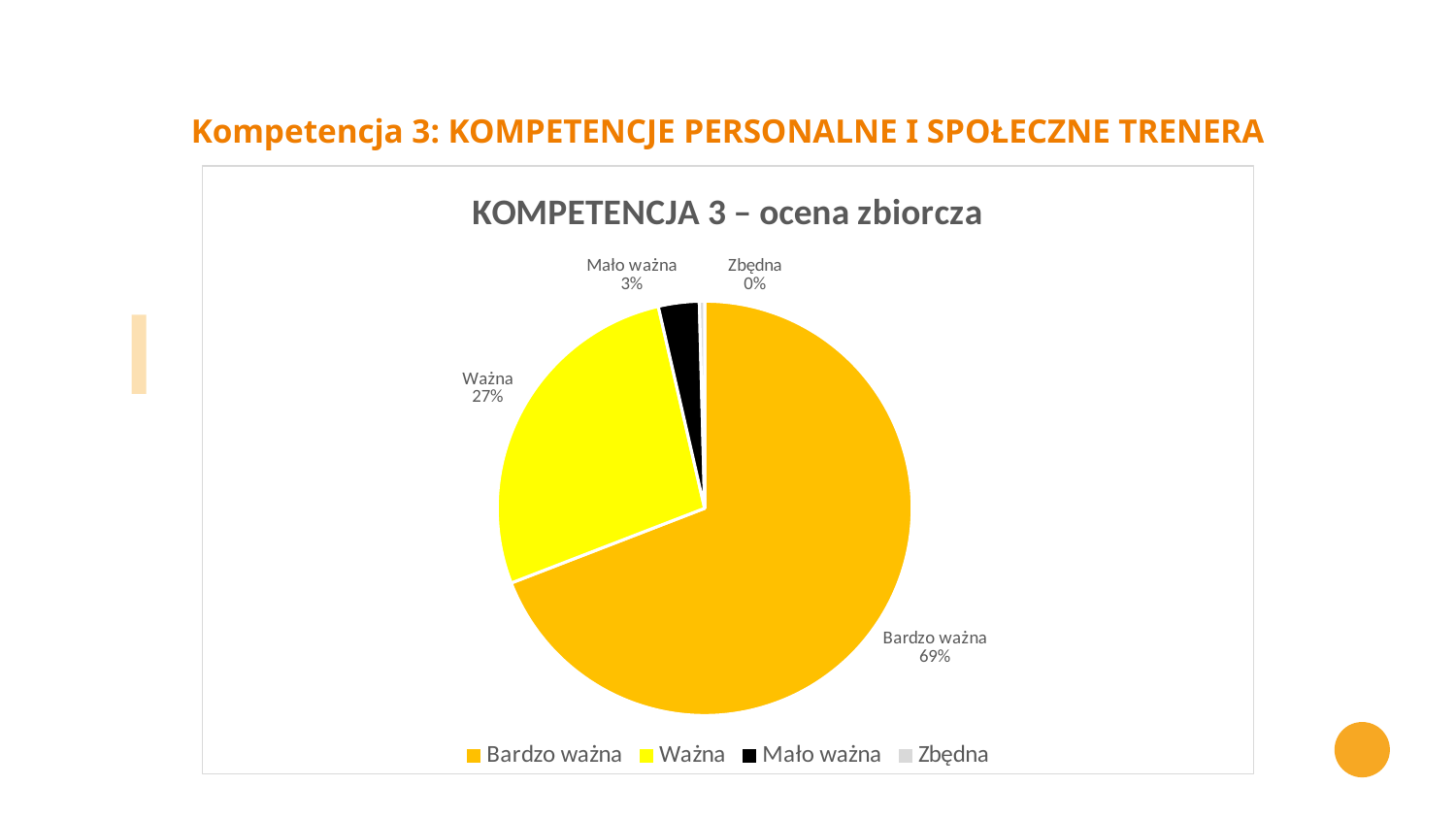
What is the value shown for "Mało ważna"? 3% What is the value shown for "Ważna"? 27% What is the value shown for "Zbędna"? 0% What colour is the slice for "Mało ważna"? Black How many categories are shown in the pie chart? 4 What kind of chart is shown on the slide? Pie chart Which category has the largest slice of the pie? Bardzo ważna Which is larger, the slice for "Ważna" or the slice for "Mało ważna"? Ważna What is the difference in percentage points between "Bardzo ważna" and "Ważna"? 42 What is the title of the chart? KOMPETENCJA 3 – ocena zbiorcza Which category has the smallest slice of the pie? Zbędna What share of the pie does "Bardzo ważna" represent? 69%